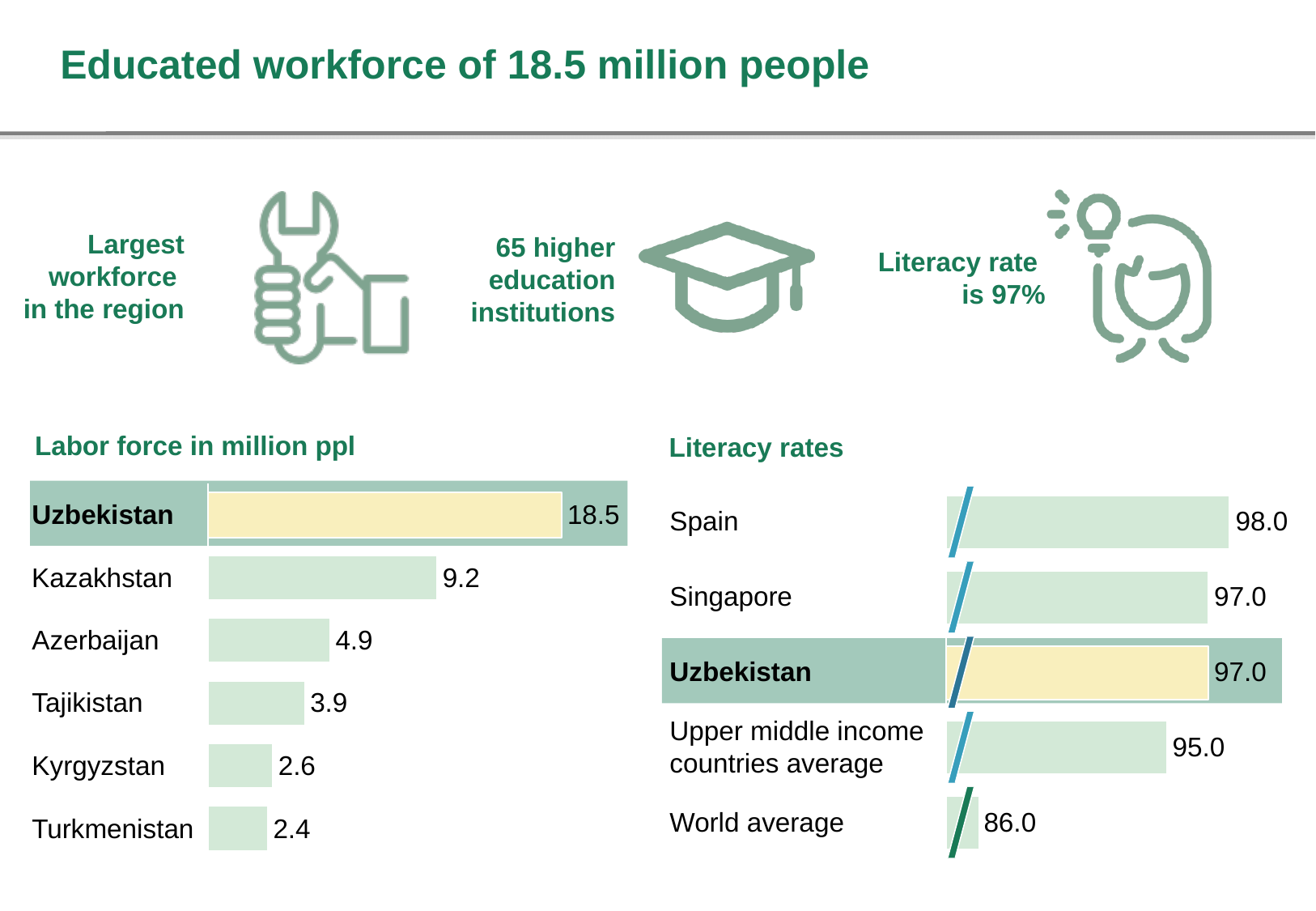
In the 'Literacy rates' chart, what is the value for Spain? 98.0 In the 'Labor force in million ppl' chart, what is the difference between Uzbekistan and Kazakhstan? 9.3 What kind of chart is the 'Literacy rates' chart? Bar chart In the 'Literacy rates' chart, how many categories are shown? 5 In the 'Literacy rates' chart, which category has the lowest value? World average In the 'Labor force in million ppl' chart, which is larger, Azerbaijan or Tajikistan? Azerbaijan In the 'Literacy rates' chart, what is the value for the World average? 86.0 In the 'Labor force in million ppl' chart, which country has the highest labor force? Uzbekistan In the 'Labor force in million ppl' chart, what is the value for Kazakhstan? 9.2 In the 'Labor force in million ppl' chart, which country has the lowest labor force? Turkmenistan In the 'Labor force in million ppl' chart, how many countries are shown? 6 In the 'Literacy rates' chart, what is the difference between Uzbekistan and the Upper middle income countries average? 2.0